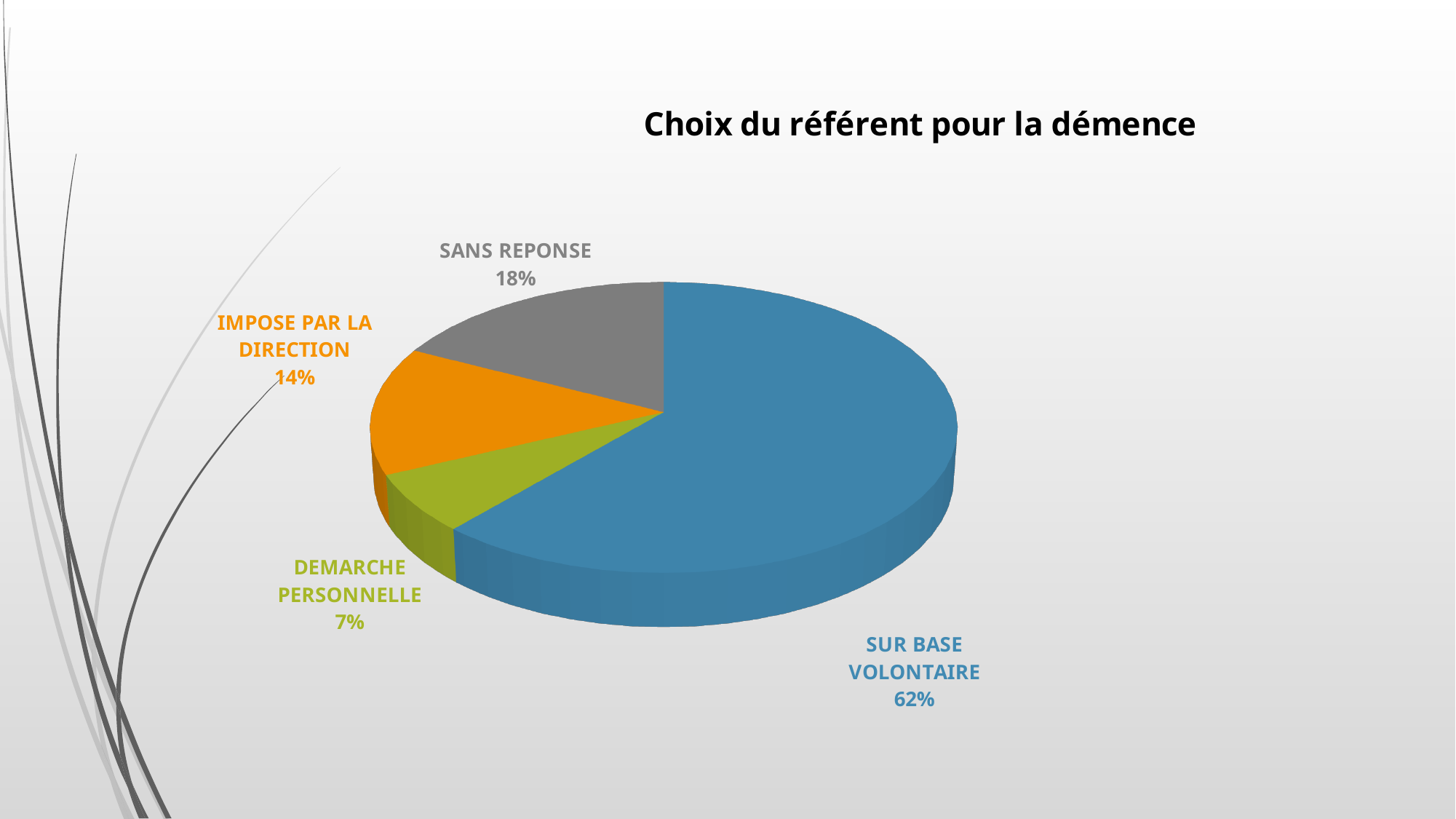
What colour is the SUR BASE VOLONTAIRE slice? blue Which category has the smallest slice? DEMARCHE PERSONNELLE What kind of chart is shown on the slide? pie chart What is the title of the chart? Choix du référent pour la démence How many slices does the pie chart have? 4 What is the value for IMPOSE PAR LA DIRECTION? 14% Which category has the largest slice? SUR BASE VOLONTAIRE Which is larger, SANS REPONSE or DEMARCHE PERSONNELLE? SANS REPONSE What share of the pie does SUR BASE VOLONTAIRE represent? 62% What is the difference between SANS REPONSE and IMPOSE PAR LA DIRECTION? 4% What is the value for DEMARCHE PERSONNELLE? 7% What is the value for SANS REPONSE? 18%